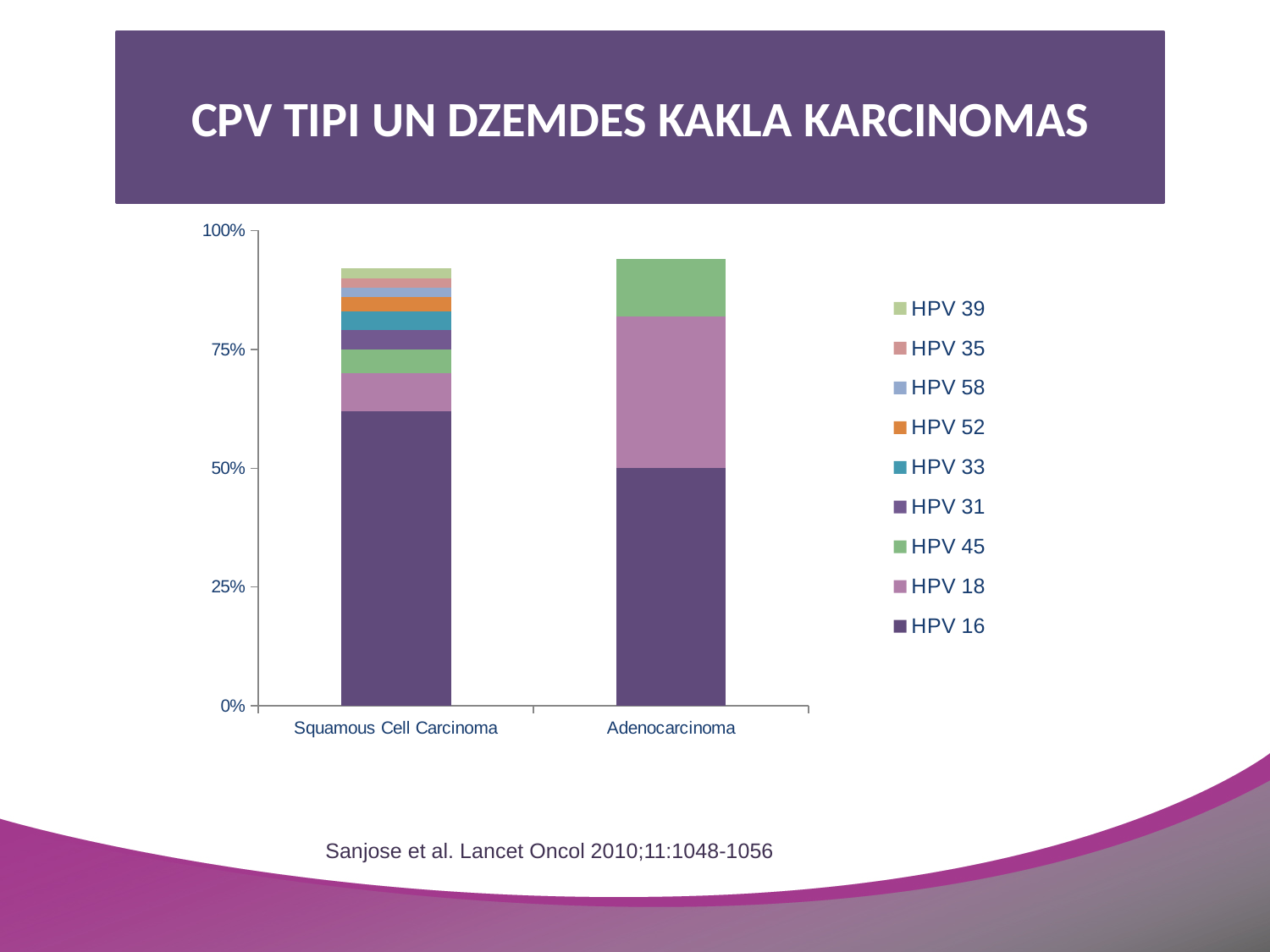
What is the HPV 16 value for Adenocarcinoma? 50% Which HPV type has the largest segment in the Squamous Cell Carcinoma bar? HPV 16 How many categories are shown on the x axis of the chart? 2 Is the total height of the Adenocarcinoma bar greater or less than 75%? greater How many series does the chart legend list? 9 What is the title of the slide containing the chart? CPV TIPI UN DZEMDES KAKLA KARCINOMAS Is the HPV 16 value for Squamous Cell Carcinoma greater or less than 50%? greater What kind of chart is shown on the slide? Stacked bar chart How many HPV type segments make up the Adenocarcinoma bar? 3 Is the HPV 18 segment larger for Squamous Cell Carcinoma or for Adenocarcinoma? Adenocarcinoma Is the HPV 16 segment larger for Squamous Cell Carcinoma or for Adenocarcinoma? Squamous Cell Carcinoma Is the HPV 16 value for Squamous Cell Carcinoma greater or less than 75%? less